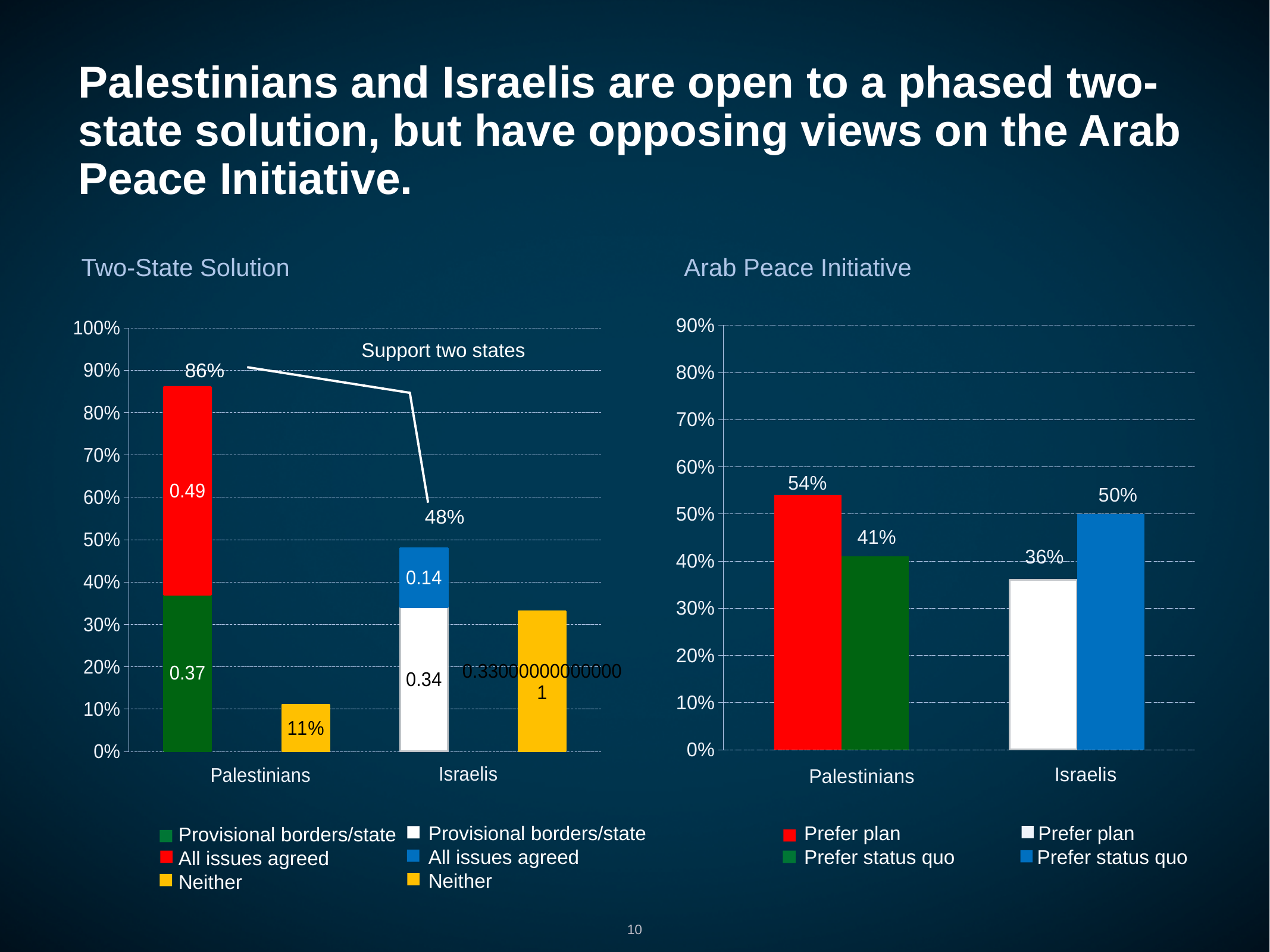
In the Arab Peace Initiative chart, what percentage of Palestinians prefer the plan? 54% In the Two-State Solution chart, what percentage of Palestinians chose 'Neither'? 11% In the Arab Peace Initiative chart, what percentage of Israelis prefer the status quo? 50% What type of chart is the Arab Peace Initiative chart? Bar chart In the Arab Peace Initiative chart, which is larger: the share of Israelis who prefer the plan or the share who prefer the status quo? Prefer status quo In the Two-State Solution chart, what total percentage of Palestinians support two states? 86% In the Two-State Solution chart, what value is labelled on the 'All issues agreed' segment for Palestinians? 0.49 In the Arab Peace Initiative chart, what percentage of Israelis prefer the plan? 36% In the Arab Peace Initiative chart, which bar is the lowest? Israelis, Prefer plan (36%) In the Arab Peace Initiative chart, what is the difference between the share of Palestinians who prefer the plan and the share who prefer the status quo? 13% In the Two-State Solution chart, is the 'Neither' bar for Israelis greater or less than 30%? greater In the Two-State Solution chart, what total percentage of Israelis support two states? 48%